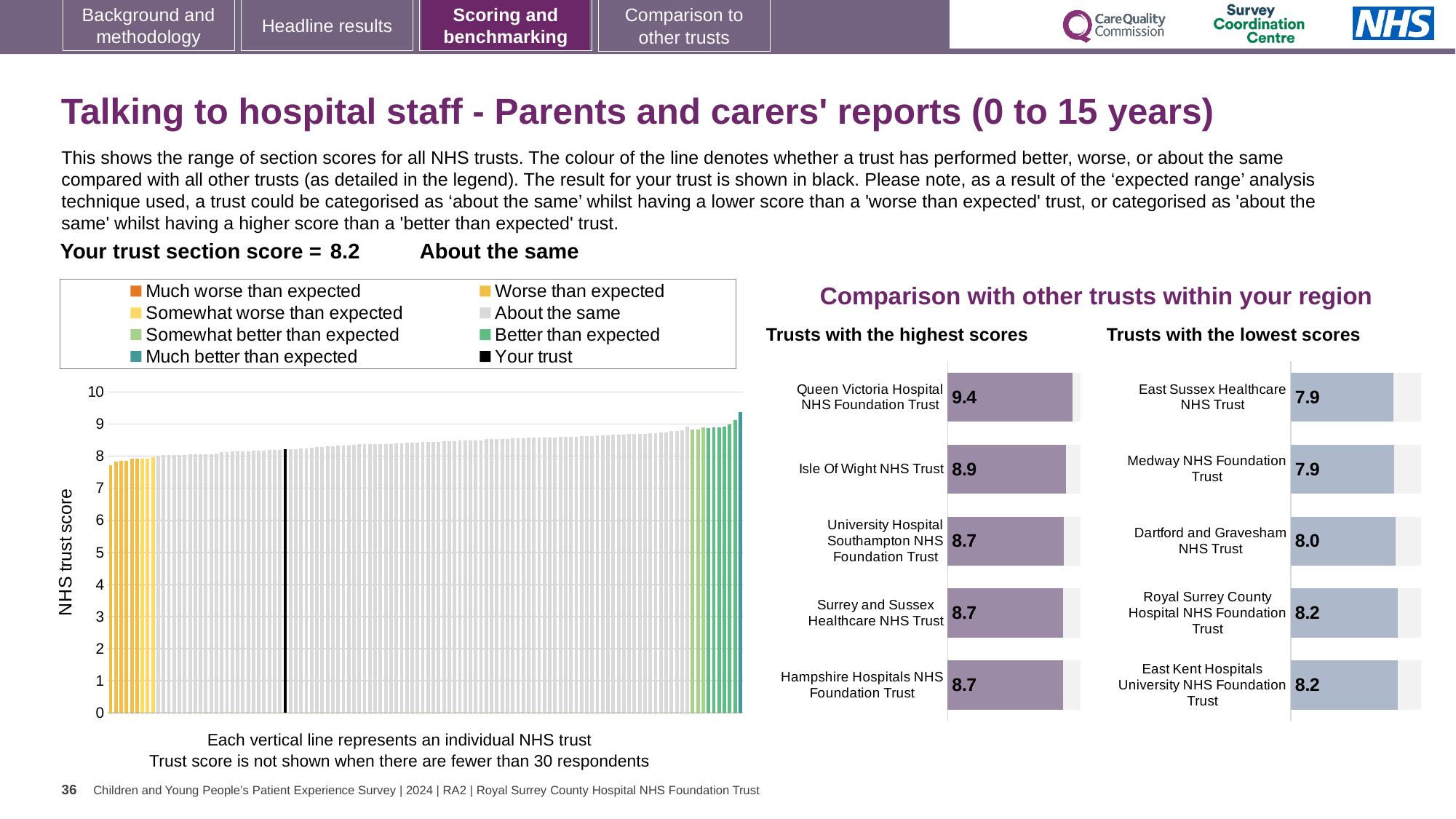
In the 'Trusts with the lowest scores' chart, what is the score for Dartford and Gravesham NHS Trust? 8.0 In the 'Trusts with the highest scores' chart, what is the difference between the scores of Queen Victoria Hospital NHS Foundation Trust and Isle Of Wight NHS Trust? 0.5 In the NHS trust score chart on the left, is the tallest bar greater or less than 9? greater In the NHS trust score chart on the left, what is the section score for your trust? 8.2 In the 'Trusts with the highest scores' chart, what is the score for Queen Victoria Hospital NHS Foundation Trust? 9.4 In the 'Trusts with the lowest scores' chart, which has the higher score: Dartford and Gravesham NHS Trust or East Kent Hospitals University NHS Foundation Trust? East Kent Hospitals University NHS Foundation Trust In the 'Trusts with the lowest scores' chart, what is the score for Royal Surrey County Hospital NHS Foundation Trust? 8.2 What kind of chart is the NHS trust score chart on the left? Bar chart In the 'Trusts with the highest scores' chart, what is the score for Hampshire Hospitals NHS Foundation Trust? 8.7 In the 'Trusts with the lowest scores' chart, how many trusts are listed? 5 In the 'Trusts with the highest scores' chart, which trust has the highest score? Queen Victoria Hospital NHS Foundation Trust How many entries does the legend of the NHS trust score chart on the left list? 8